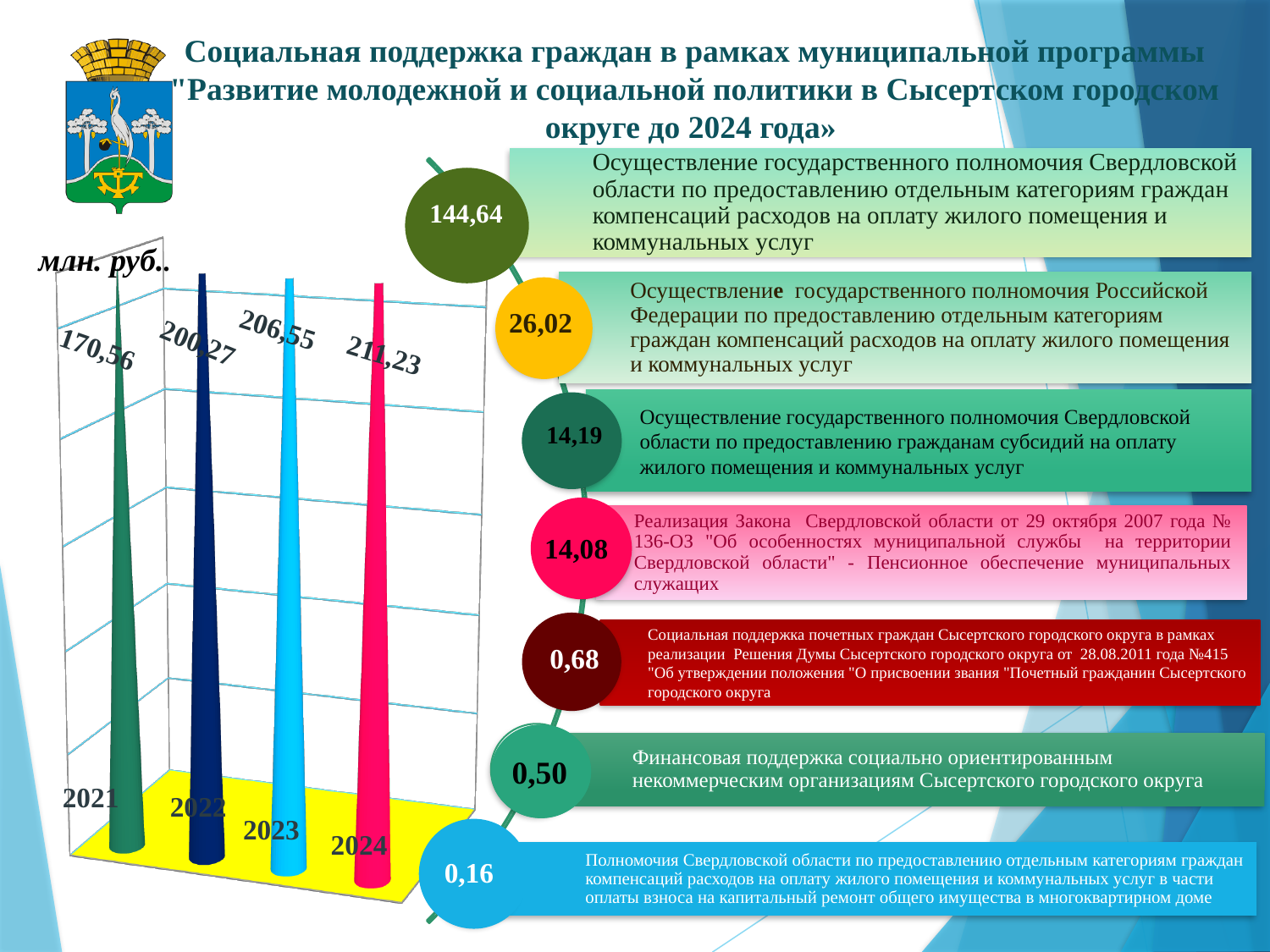
What is the difference between the values for 2023 and 2022? 6,28 What is the value for 2022 on the chart? 200,27 Do the values rise or fall from 2021 to 2024? rise What unit of measurement is indicated for the chart? млн. руб. What is the value for 2021 on the chart? 170,56 Which is larger, the value for 2022 or the value for 2021? 2022 What is the difference between the values for 2024 and 2021? 40,67 How many years are shown on the chart? 4 What is the value for 2023 on the chart? 206,55 What is the value for 2024 on the chart? 211,23 Which year has the lowest value on the chart? 2021 Which year has the highest value on the chart? 2024